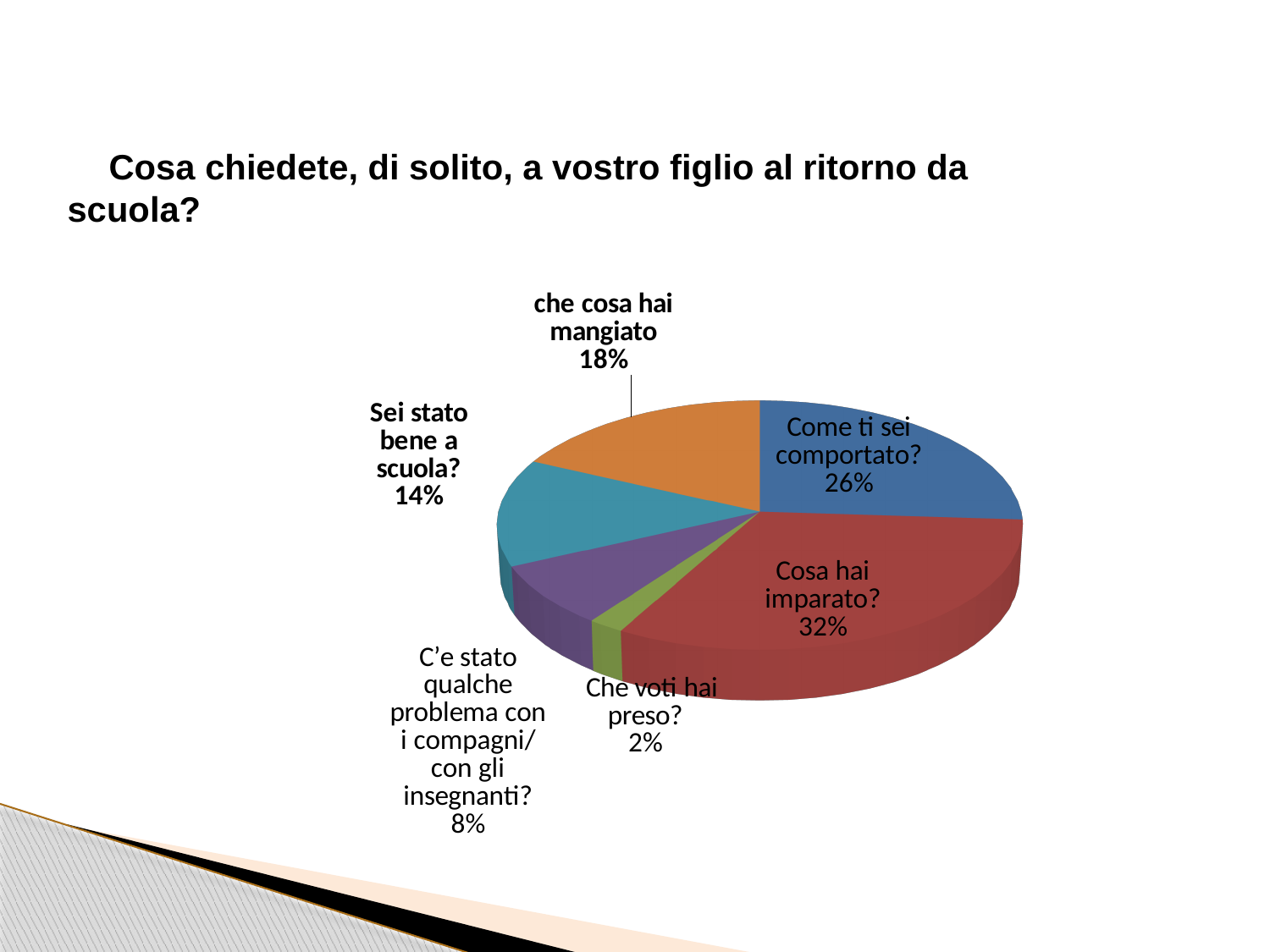
What share of the pie is labelled "Che voti hai preso?"? 2% What share of the pie is labelled "che cosa hai mangiato"? 18% What share of the pie is labelled "Come ti sei comportato?"? 26% What kind of chart is shown on the slide? pie chart Which slice of the pie is the smallest? Che voti hai preso? What share of the pie is labelled "Cosa hai imparato?"? 32% What is the title of the slide above the chart? Cosa chiedete, di solito, a vostro figlio al ritorno da scuola? How many slices does the pie chart have? 6 What share of the pie is labelled "Sei stato bene a scuola?"? 14% Which is larger: "che cosa hai mangiato" or "Sei stato bene a scuola?"? che cosa hai mangiato Which slice of the pie is the largest? Cosa hai imparato? What is the difference in percentage points between "Cosa hai imparato?" and "Come ti sei comportato?"? 6